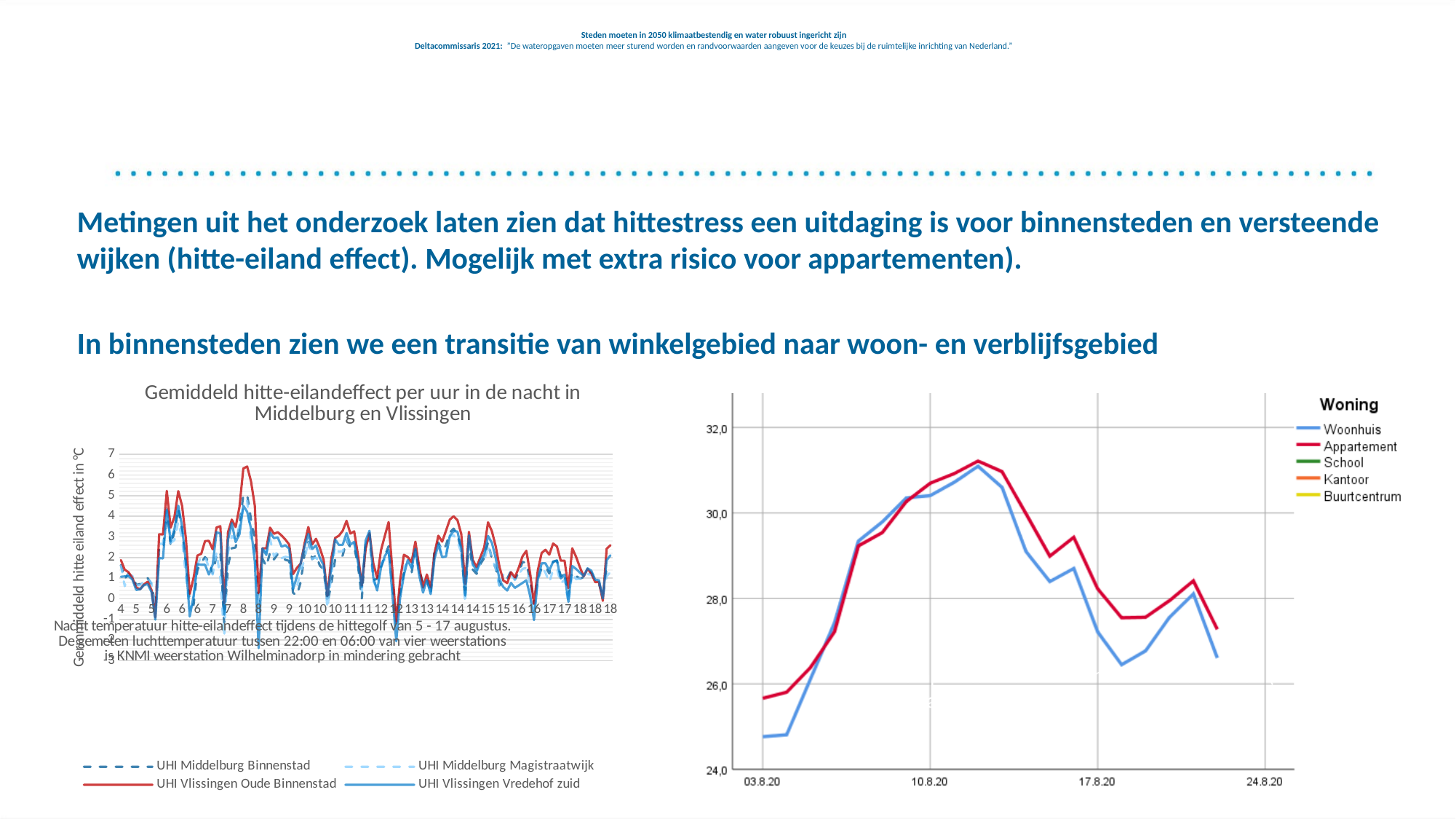
What is the title of the legend on the right chart? Woning In the right chart, is the peak value of the Appartement line greater or less than 30,0? greater In the right chart, do the values rise or fall between 03.8.20 and 10.8.20? rise In the right chart, is the value of Woonhuis at 03.8.20 greater or less than 26,0? less In the right chart, which line is higher at 03.8.20, Woonhuis or Appartement? Appartement How many series does the legend of the left chart list? 4 What is the y-axis label of the left chart? Gemiddeld hitte eiland effect in °C In the left chart, is the peak value of UHI Vlissingen Oude Binnenstad greater or less than 6? greater What kind of chart is the left chart titled 'Gemiddeld hitte-eilandeffect per uur in de nacht in Middelburg en Vlissingen'? Line chart What kind of chart is the right chart with the 'Woning' legend? Line chart How many entries does the 'Woning' legend of the right chart list? 5 In the left chart, which series reaches the highest value? UHI Vlissingen Oude Binnenstad